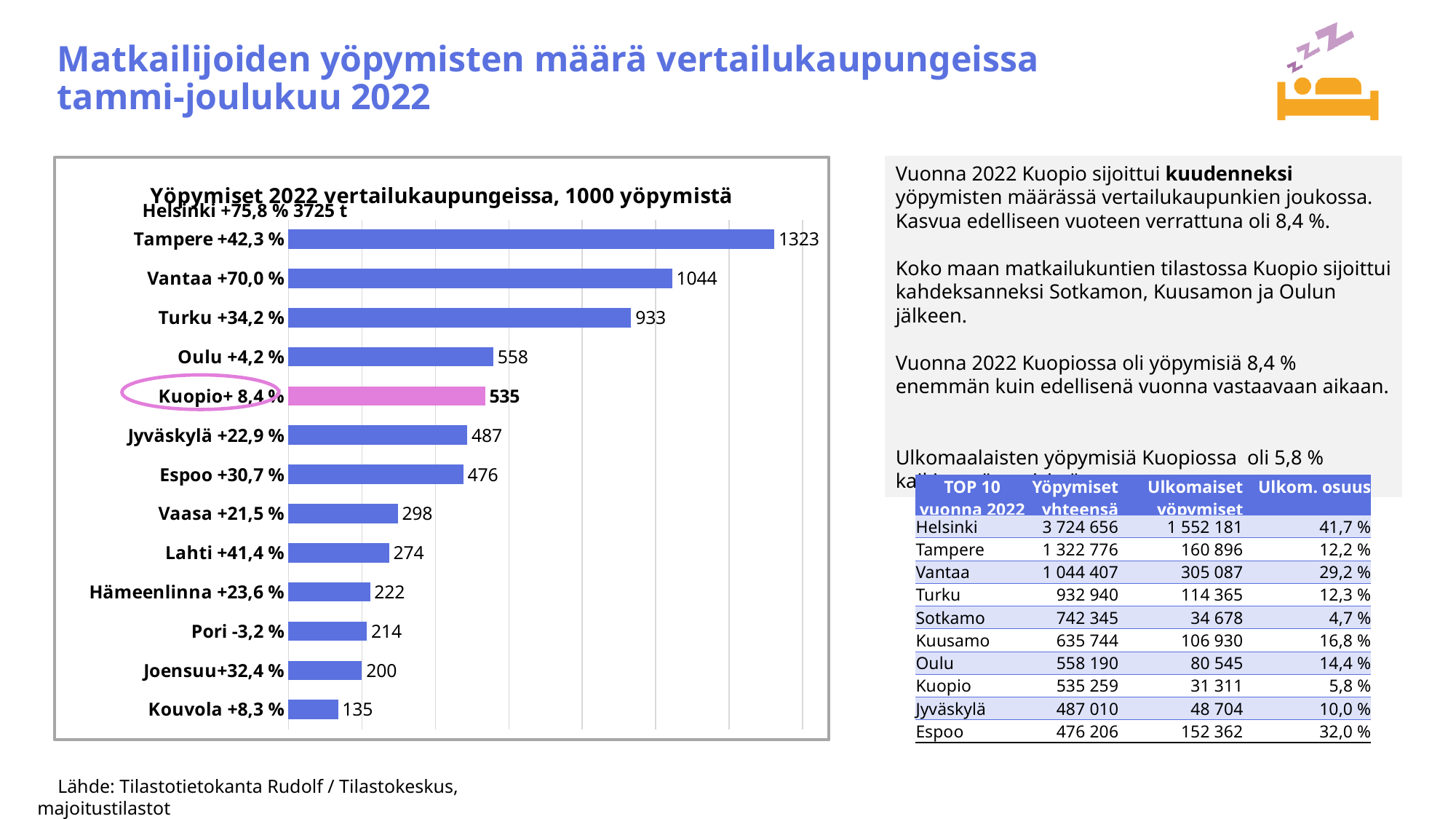
Which city's bar is highlighted in pink in the chart? Kuopio Which has a larger value, Oulu or Kuopio? Oulu What is the value for Tampere in the chart? 1323 What is the value for Kouvola in the chart? 135 What is the value for Kuopio in the chart? 535 What is the difference between the values for Tampere and Vantaa? 279 Which city has the shortest bar in the chart? Kouvola What is the difference between the values for Kuopio and Jyväskylä? 48 What type of chart is shown on the slide? bar chart What is the value for Hämeenlinna in the chart? 222 Which city has the longest bar in the chart? Tampere Do the bar values rise or fall going from the top of the chart to the bottom? fall